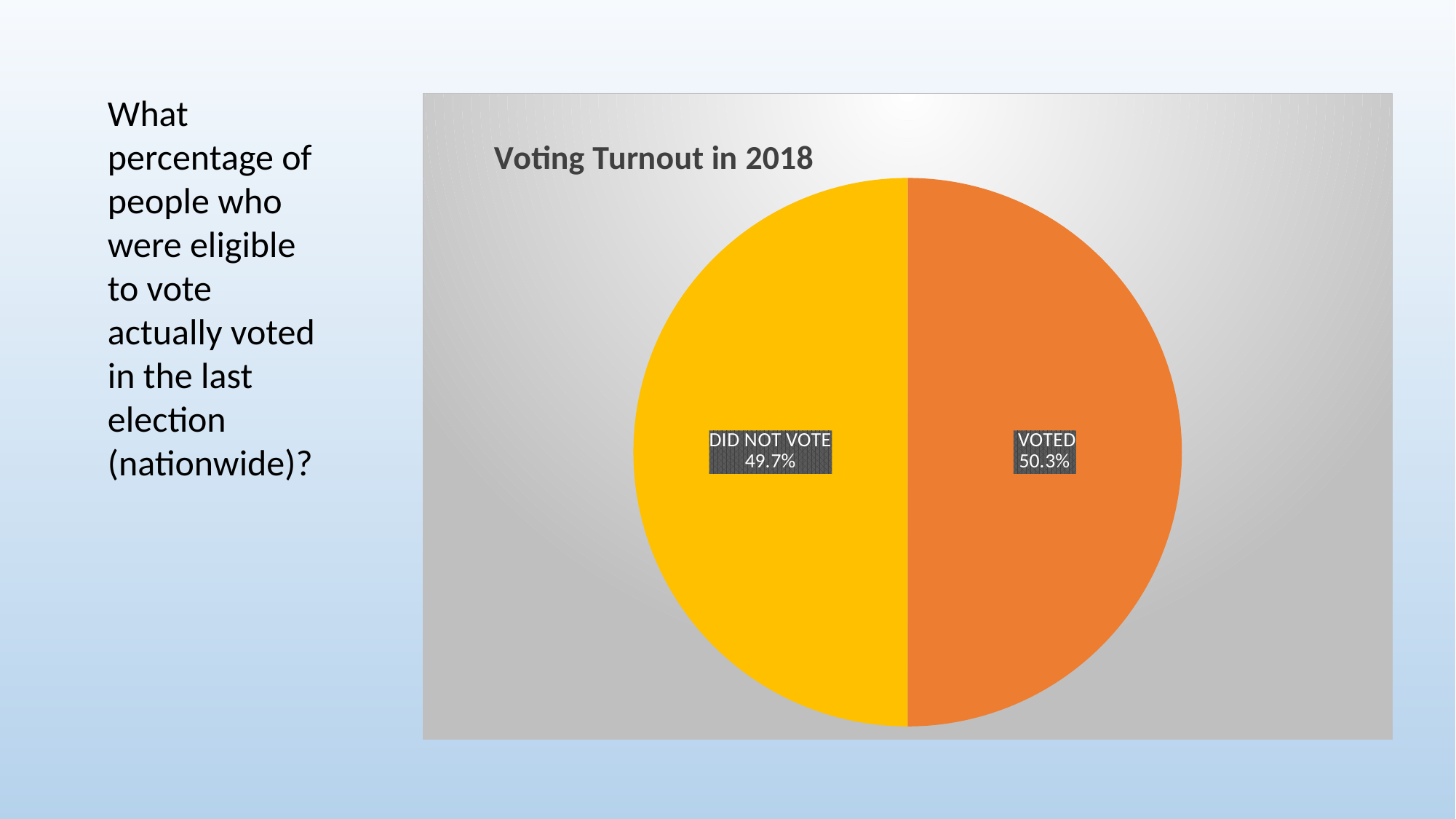
Which category has the largest share of the pie? VOTED What percentage is shown for the VOTED slice? 50.3% Is the value for VOTED greater or less than 50%? greater What colour is the VOTED slice? orange What is the title of the chart? Voting Turnout in 2018 Which category has the smallest share of the pie? DID NOT VOTE What share of the pie does the DID NOT VOTE slice represent? 49.7% How many slices does the pie chart have? 2 What is the difference between the VOTED and DID NOT VOTE percentages? 0.6% What percentage is shown for the DID NOT VOTE slice? 49.7% What type of chart is shown on the slide? pie chart Which slice is larger, VOTED or DID NOT VOTE? VOTED